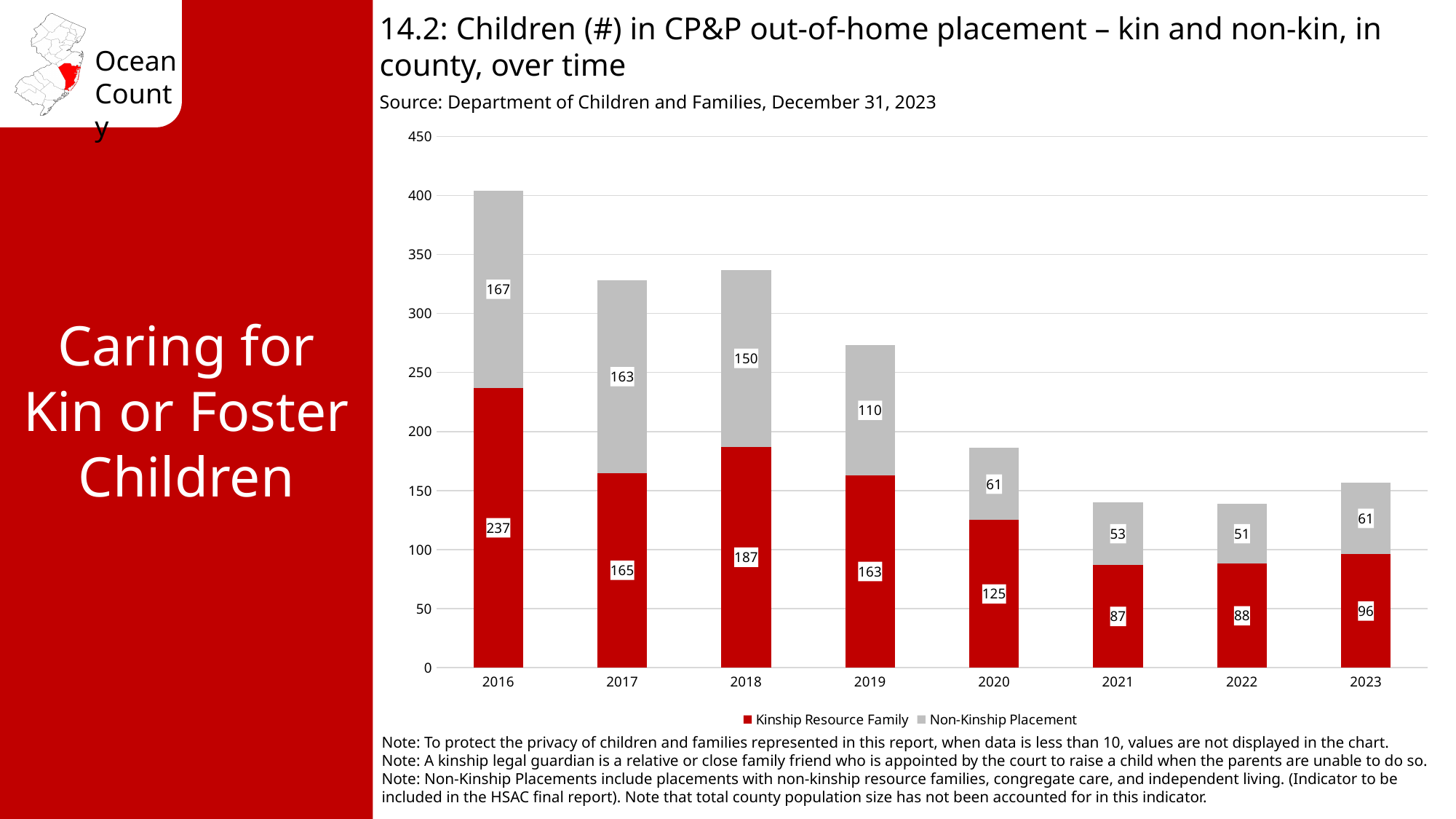
What is the total of the stacked bar for 2021? 140 What is the total of the stacked bar for 2016? 404 What type of chart is shown? Stacked bar chart What is the Kinship Resource Family value for 2016? 237 Which year has the lowest Non-Kinship Placement value? 2022 How many years are shown on the x axis? 8 What is the Kinship Resource Family value for 2023? 96 What is the difference between the Kinship Resource Family values for 2016 and 2017? 72 Which year has the highest Kinship Resource Family value? 2016 Which is larger, the Non-Kinship Placement value for 2018 or for 2019? 2018 How many series does the legend list? 2 What is the Non-Kinship Placement value for 2019? 110